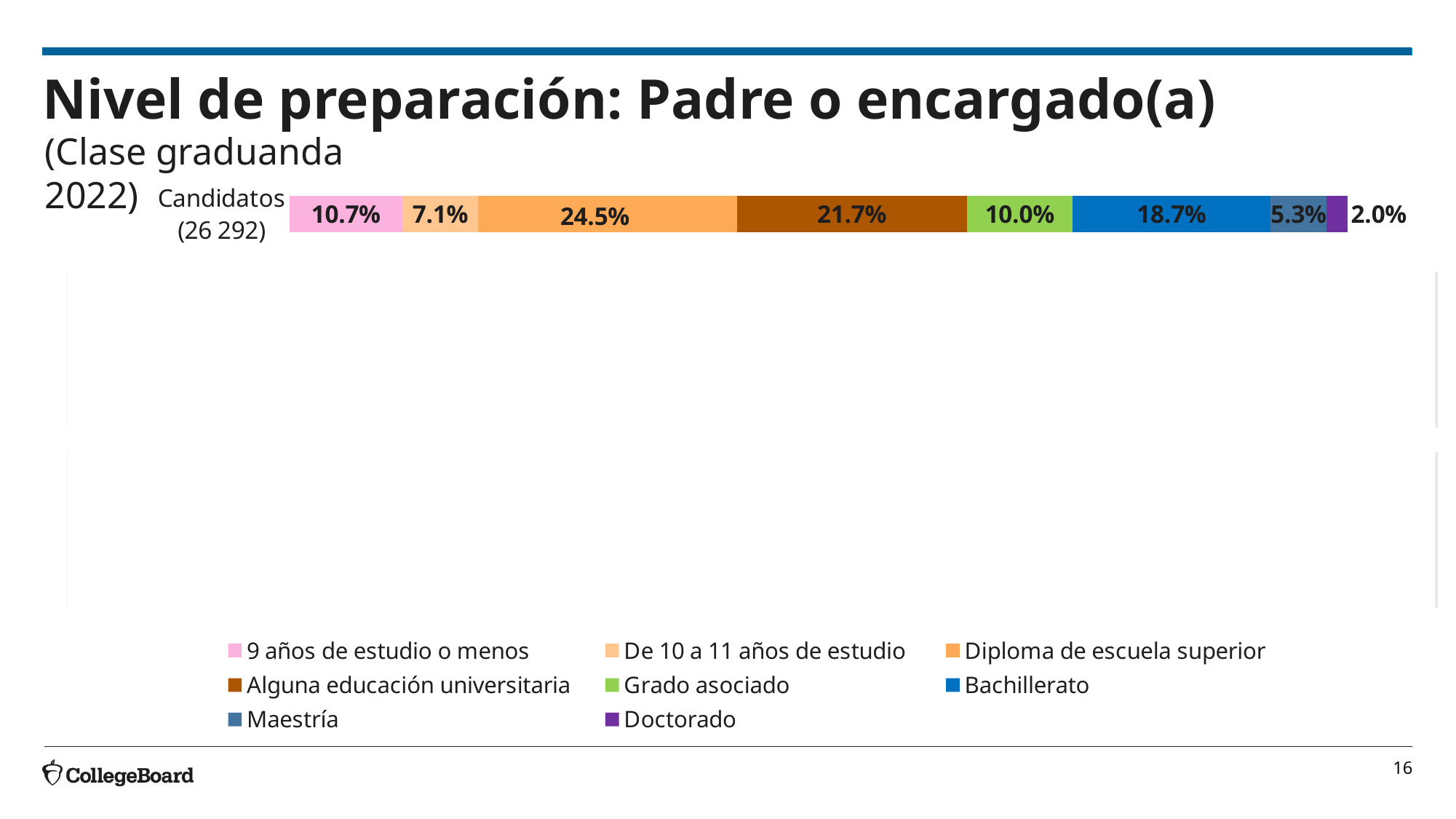
How many candidates are indicated in the bar's category label? 26 292 What is the difference between the Diploma de escuela superior share and the Alguna educación universitaria share? 2.8% Which education level has the largest share of the bar? Diploma de escuela superior What is the total of all segments in the Candidatos bar? 100.0% What kind of chart is shown on the slide? Stacked bar chart What is the value for Alguna educación universitaria? 21.7% What percentage is shown for Doctorado? 2.0% Which is larger, the share for 9 años de estudio o menos or the share for Grado asociado? 9 años de estudio o menos What percentage of candidates' parents or guardians have a Diploma de escuela superior? 24.5% Which education level has the smallest share of the bar? Doctorado How many series does the legend list? 8 What is the value shown for Bachillerato? 18.7%